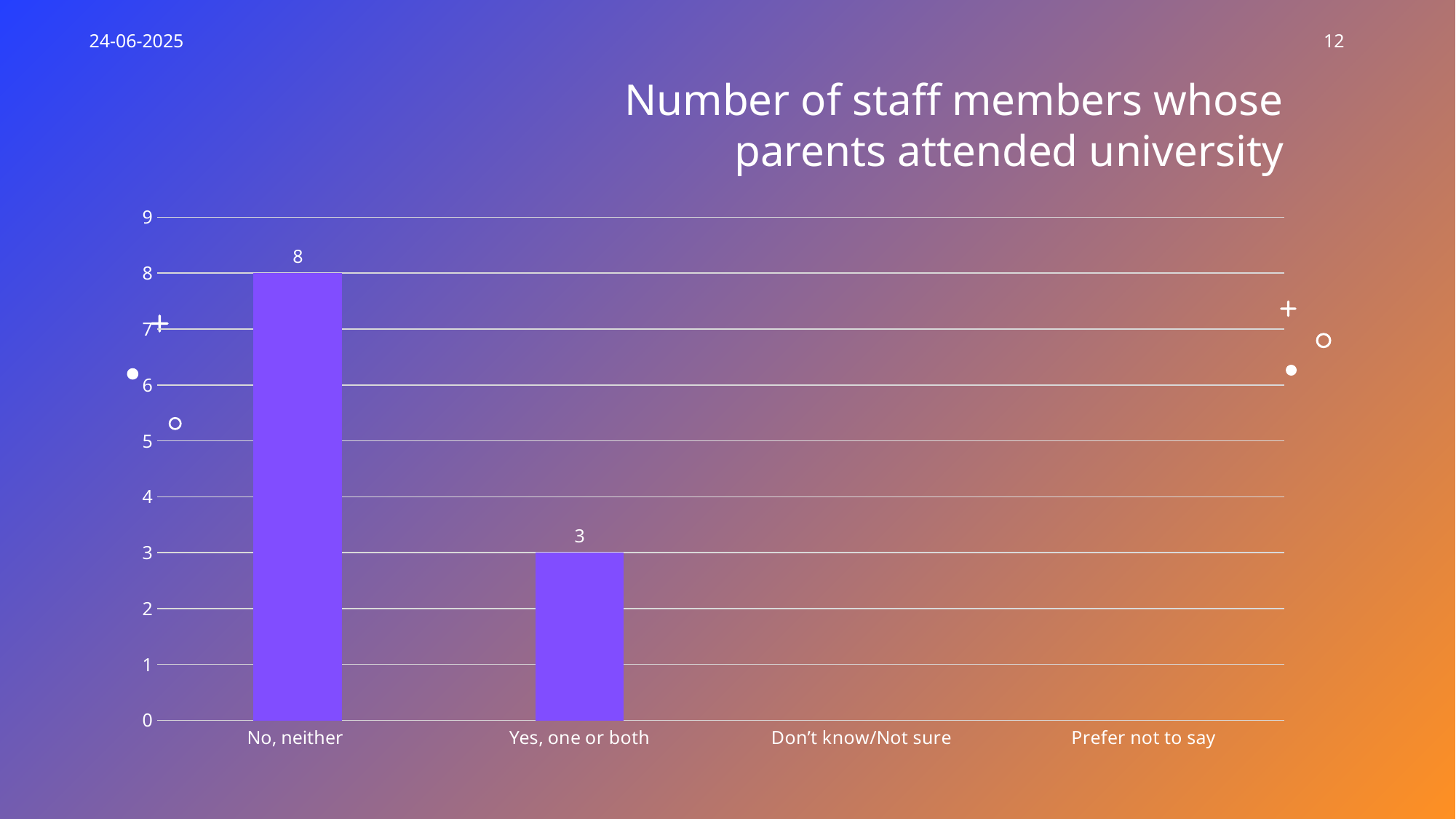
What is the total of the values for "No, neither" and "Yes, one or both"? 11 What is the highest value shown on the y axis? 9 Is the value for "No, neither" greater or less than 5? greater What is the difference between the values for "No, neither" and "Yes, one or both"? 5 Which category has the highest value? No, neither Is the value for "Yes, one or both" greater or less than 5? less What is the value for "No, neither"? 8 What is the title of the chart? Number of staff members whose parents attended university What is the value for "Yes, one or both"? 3 How many categories are shown on the x axis? 4 Which is larger, the value for "No, neither" or the value for "Yes, one or both"? No, neither What kind of chart is shown on the slide? bar chart